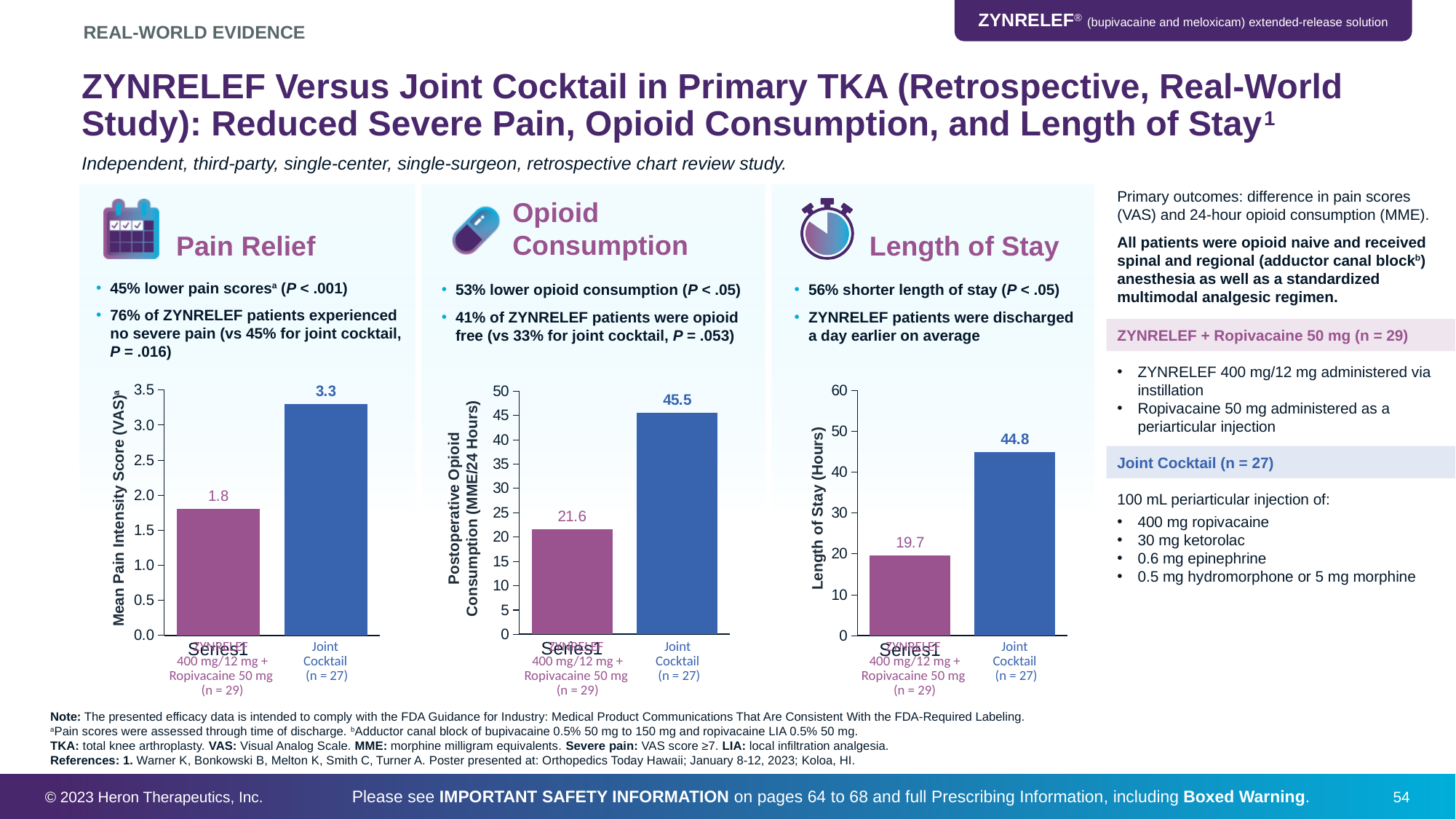
In the Length of Stay chart, what is the difference in length of stay between the Joint Cocktail and ZYNRELEF + Ropivacaine groups? 25.1 In the Length of Stay chart, what is the length of stay in hours for the Joint Cocktail group? 44.8 In the Length of Stay chart, which group has the shorter length of stay? ZYNRELEF + Ropivacaine In the Length of Stay chart, what is the length of stay in hours for the ZYNRELEF + Ropivacaine group? 19.7 In the Pain Relief chart, what is the mean pain intensity score for the ZYNRELEF + Ropivacaine group? 1.8 What type of chart is the Opioid Consumption chart? Bar chart In the Opioid Consumption chart, what is the postoperative opioid consumption for the ZYNRELEF + Ropivacaine group? 21.6 In the Pain Relief chart, what is the mean pain intensity score for the Joint Cocktail group? 3.3 How many bars are shown in the Pain Relief chart? 2 In the Pain Relief chart, what is the difference in mean pain intensity score between the Joint Cocktail and ZYNRELEF + Ropivacaine groups? 1.5 In the Opioid Consumption chart, which group has the higher postoperative opioid consumption? Joint Cocktail In the Opioid Consumption chart, what is the postoperative opioid consumption for the Joint Cocktail group? 45.5